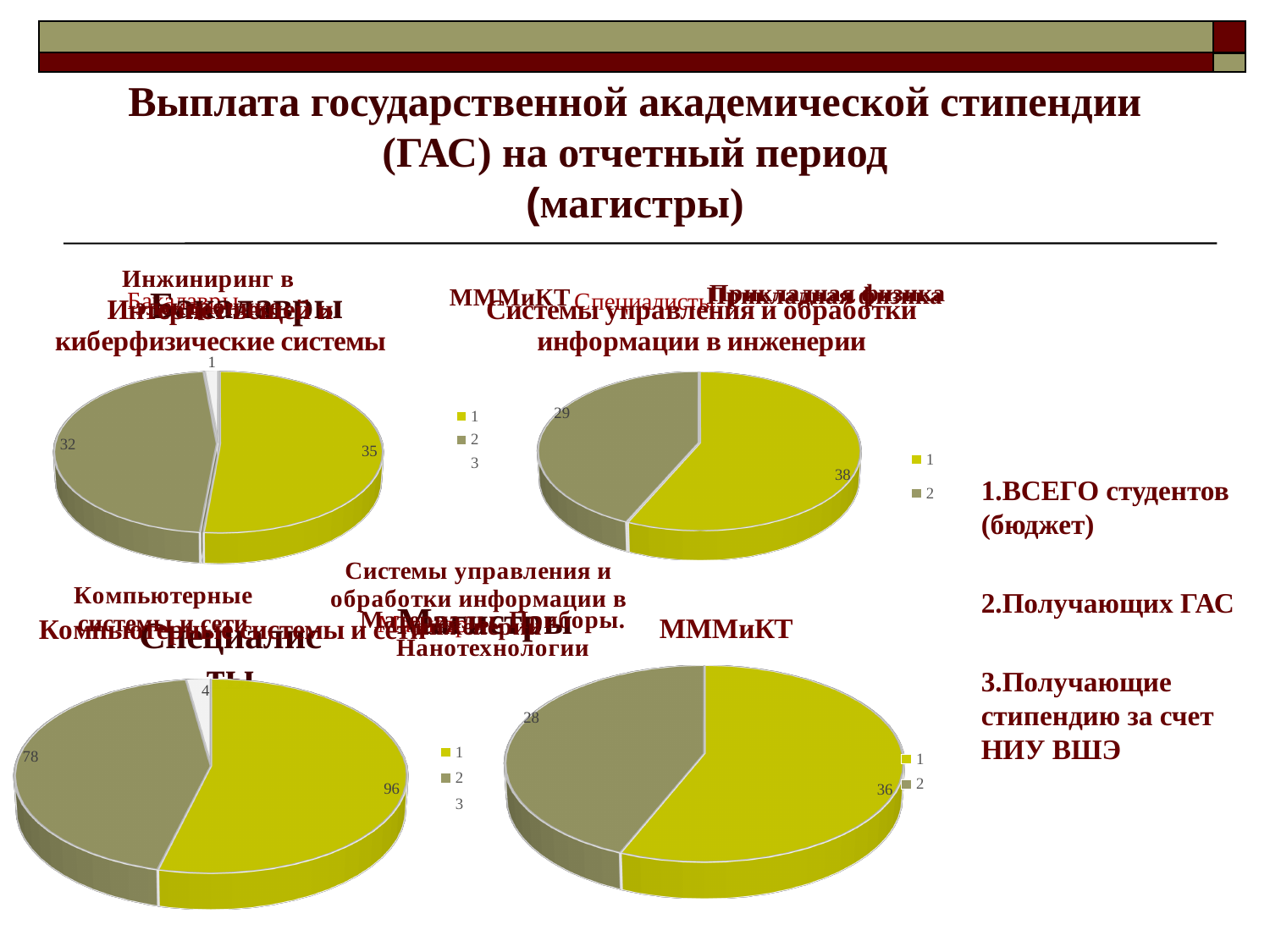
In the top-right pie chart, what is the value for series 2? 29 In the top-left pie chart, what is the value for series 3? 1 How many entries does the legend of the top-right pie chart list? 2 In the bottom-left pie chart, which series has the smallest slice? 3 In the bottom-right pie chart (МММиКТ), what is the value for series 1? 36 What type of chart is used in the bottom-right chart (МММиКТ)? Pie chart In the bottom-left pie chart, which series has the largest slice? 1 In the top-left pie chart, what is the value for series 1? 35 In the top-right pie chart, what is the difference between the values for series 1 and series 2? 9 How many slices does the bottom-left pie chart have? 3 In the bottom-right pie chart (МММиКТ), which is larger, series 1 or series 2? 1 In the bottom-left pie chart, what is the value for series 2? 78